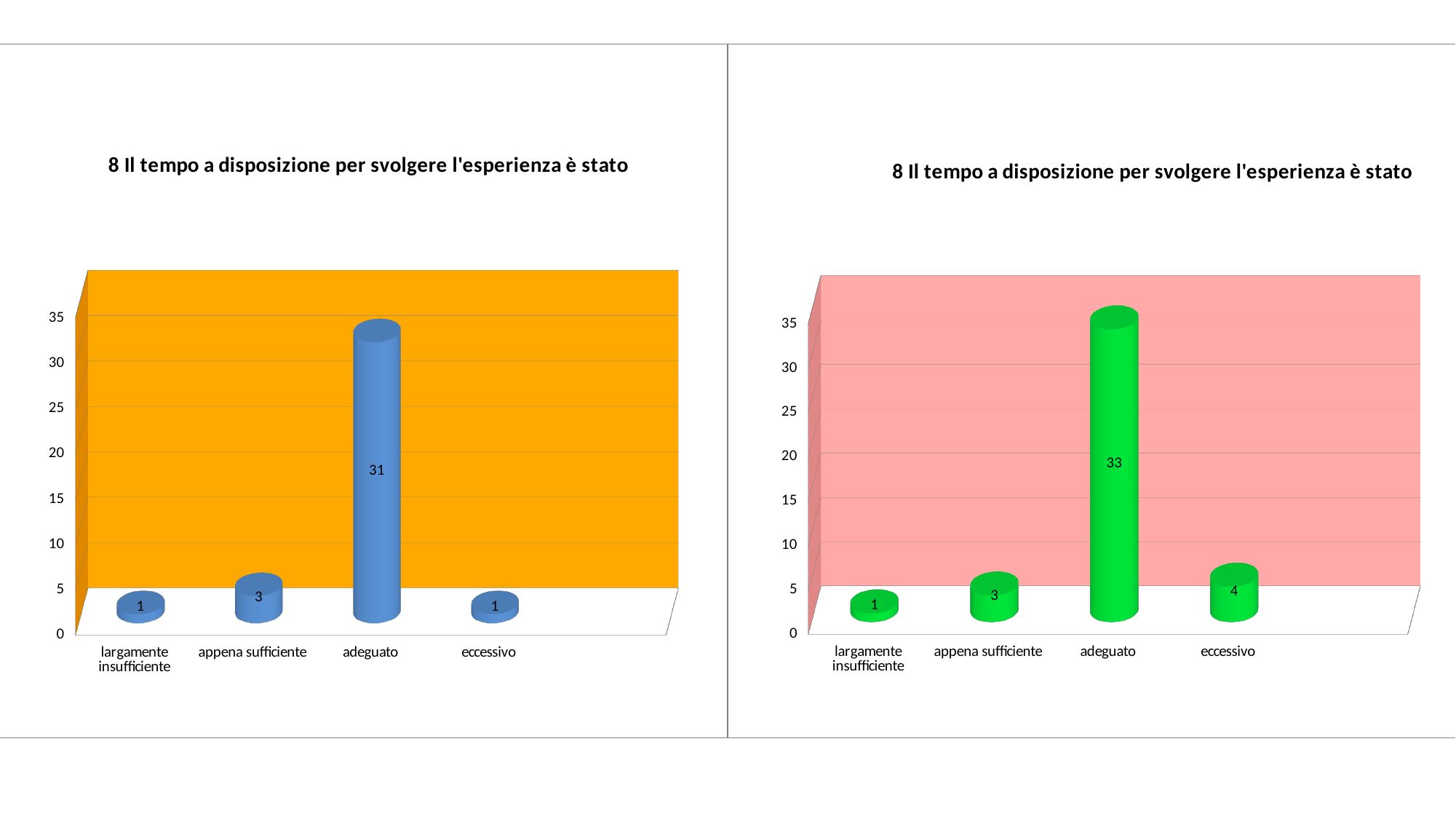
In the left chart, is the value for 'adeguato' greater or less than 30? greater In the left chart, which category has the highest value? adeguato In the left chart, what is the value for 'appena sufficiente'? 3 In the left chart, what is the value for 'adeguato'? 31 In the right chart, what is the difference between the values for 'adeguato' and 'eccessivo'? 29 How many categories are shown on the x axis of the right chart? 4 In the right chart, what is the value for 'adeguato'? 33 What kind of chart is the left chart? bar chart Which chart has the larger value for 'eccessivo', the left chart or the right chart? the right chart In the right chart, which category has the lowest value? largamente insufficiente In the left chart, what is the difference between the values for 'appena sufficiente' and 'eccessivo'? 2 In the right chart, what is the value for 'eccessivo'? 4